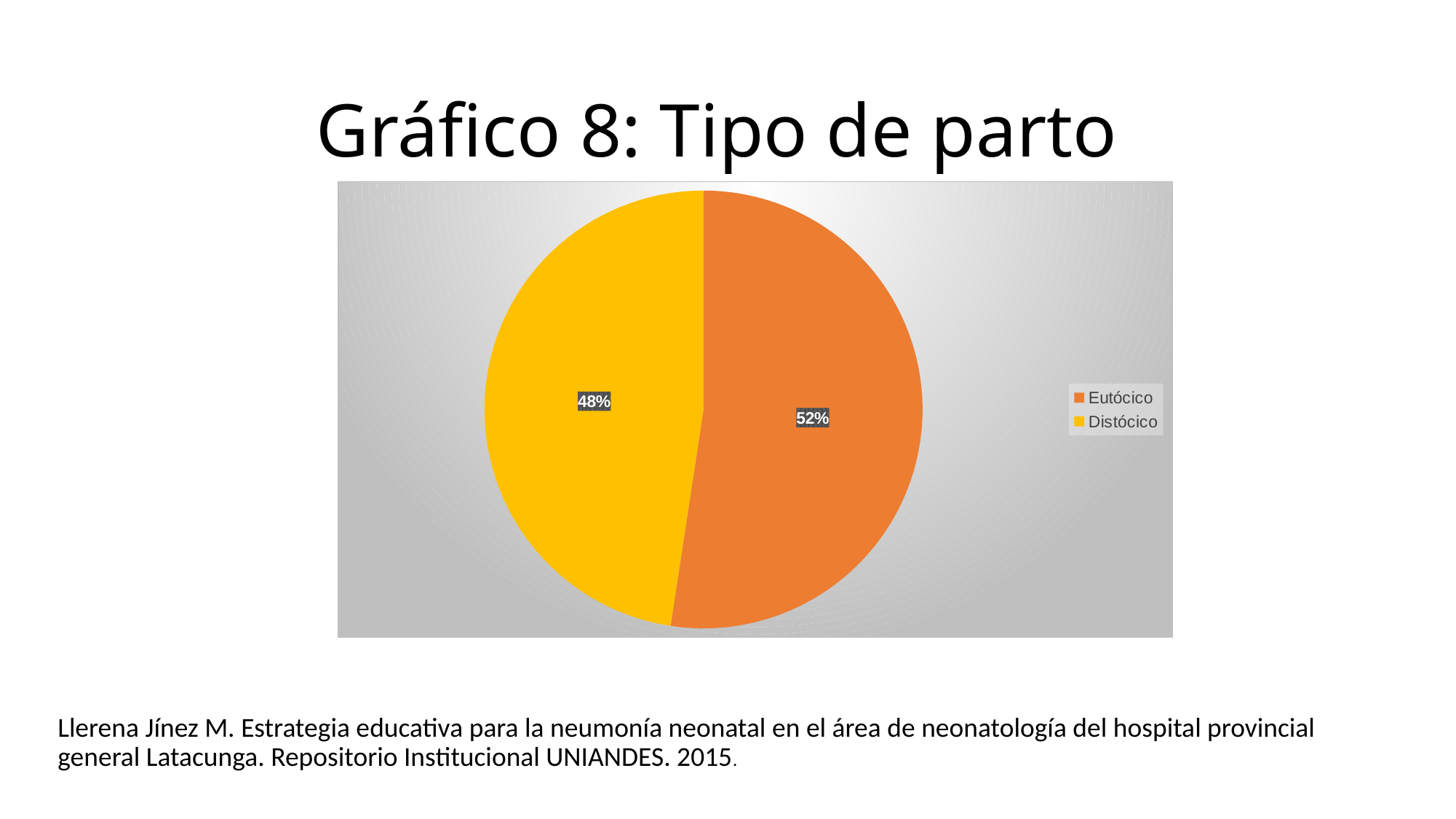
Which is larger, the Eutócico slice or the Distócico slice? Eutócico How many entries does the legend list? 2 Which category has the largest slice of the pie? Eutócico Which category has the smallest slice of the pie? Distócico How many categories does the pie chart show? 2 What is the difference in percentage points between Eutócico and Distócico? 4% What colour is the Distócico slice? yellow What is the title of the chart on the slide? Gráfico 8: Tipo de parto What share of the pie does Distócico represent? 48% What kind of chart is shown on the slide? pie chart What share of the pie does Eutócico represent? 52%